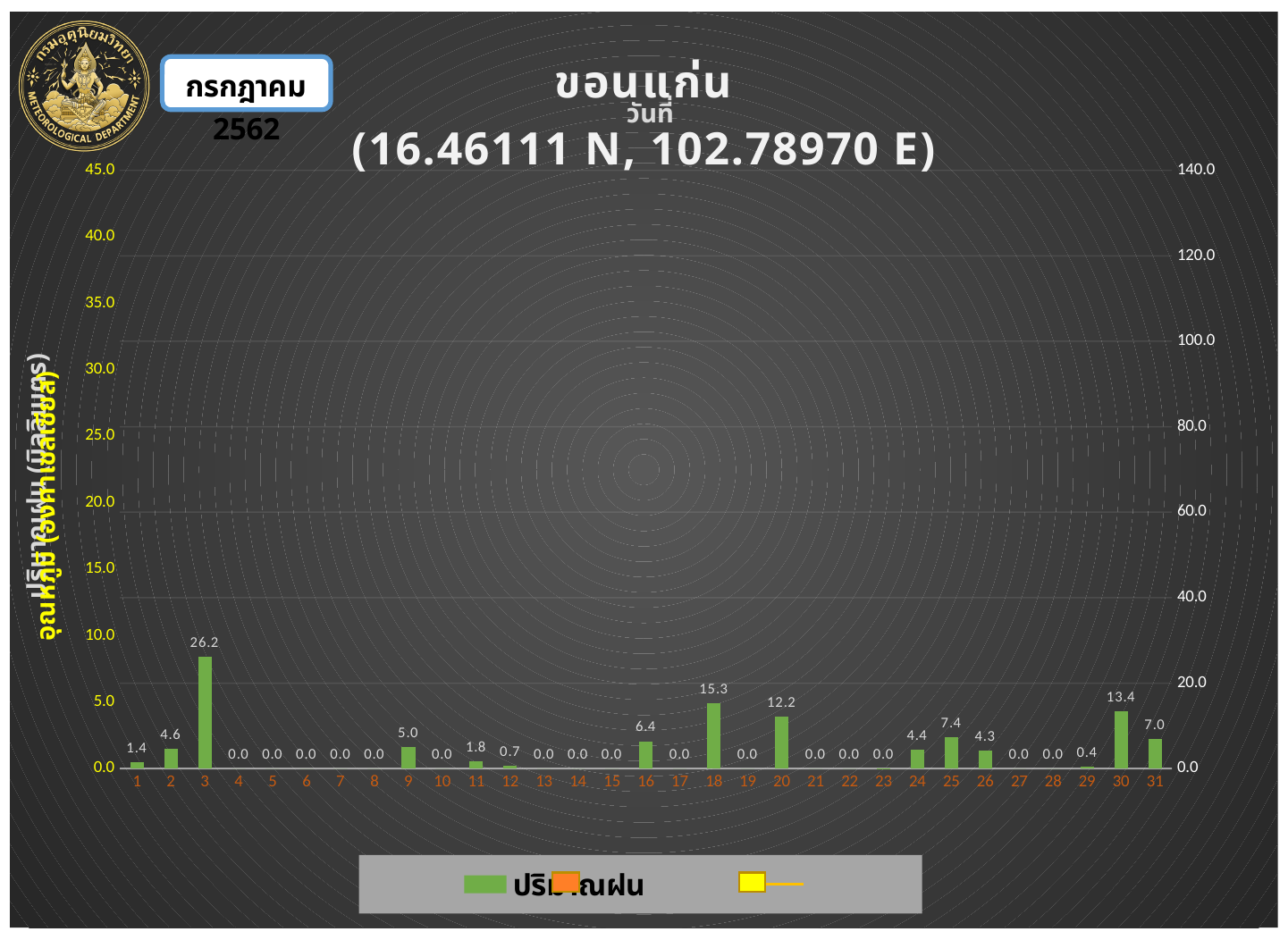
Which day has the highest rainfall value? 3 What kind of chart is used to show the rainfall values? bar chart What are the coordinates shown in the chart title? 16.46111 N, 102.78970 E Which is larger, the rainfall value for day 30 or for day 20? day 30 What is the rainfall value shown for day 3? 26.2 What is the rainfall value shown for day 25? 7.4 What is the rainfall value shown for day 18? 15.3 What is the difference between the rainfall values for day 3 and day 18? 10.9 How many days are shown on the x axis? 31 Which is larger, the rainfall value for day 9 or for day 2? day 9 What is the rainfall value shown for day 30? 13.4 What is the difference between the rainfall values for day 20 and day 16? 5.8